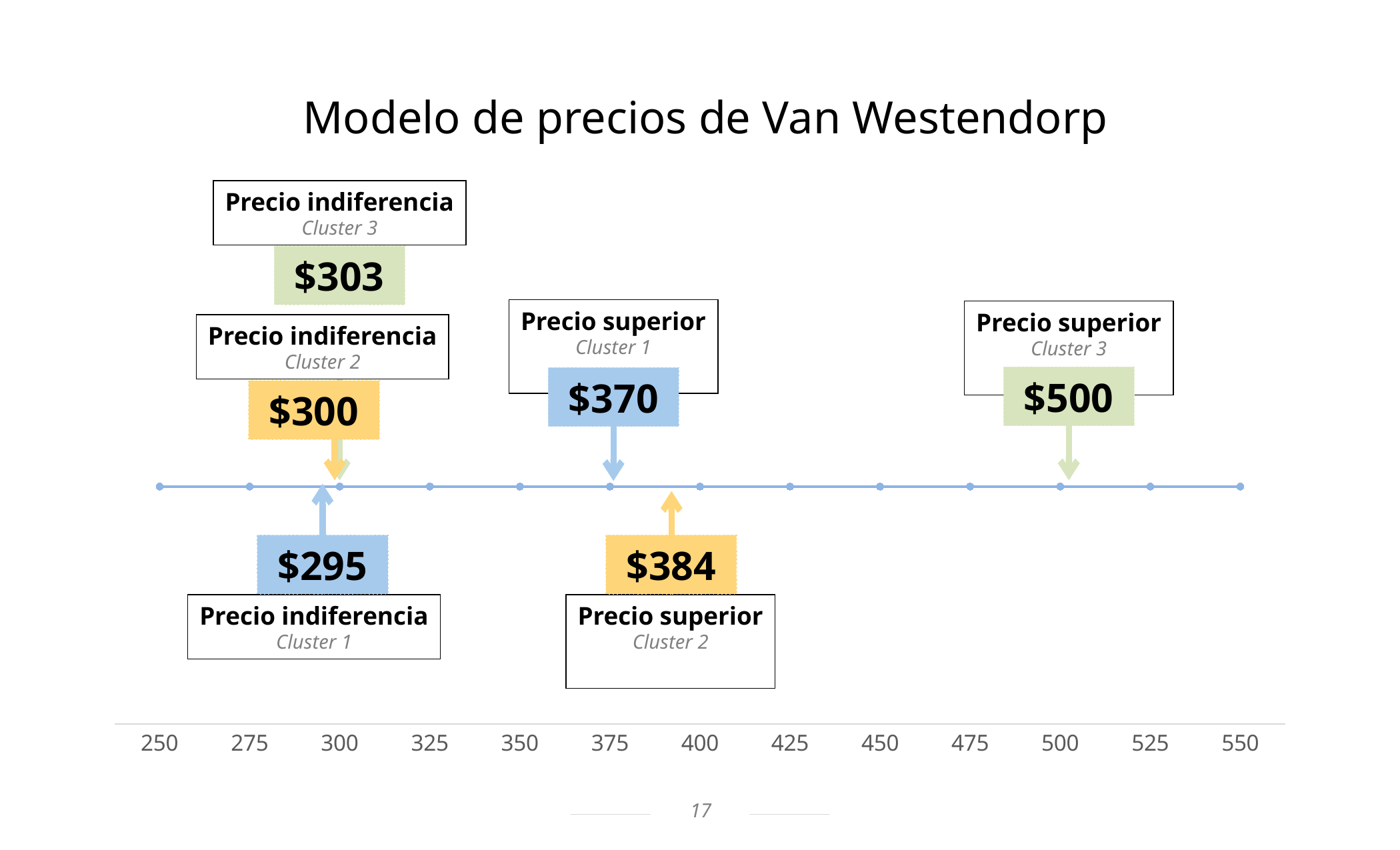
What is the Precio indiferencia for Cluster 1? $295 What is the difference between the Precio superior and the Precio indiferencia for Cluster 1? $75 What is the Precio superior for Cluster 2? $384 Which is larger, the Precio indiferencia for Cluster 2 or for Cluster 3? Cluster 3 What is the title of the chart? Modelo de precios de Van Westendorp Is the Precio superior for Cluster 1 greater or less than 400? less What is the Precio superior for Cluster 3? $500 Which cluster has the highest Precio superior? Cluster 3 Which cluster has the lowest Precio indiferencia? Cluster 1 What is the difference between the Precio superior of Cluster 3 and the Precio superior of Cluster 2? $116 How many price points are marked on the chart? 6 What is the Precio indiferencia for Cluster 3? $303